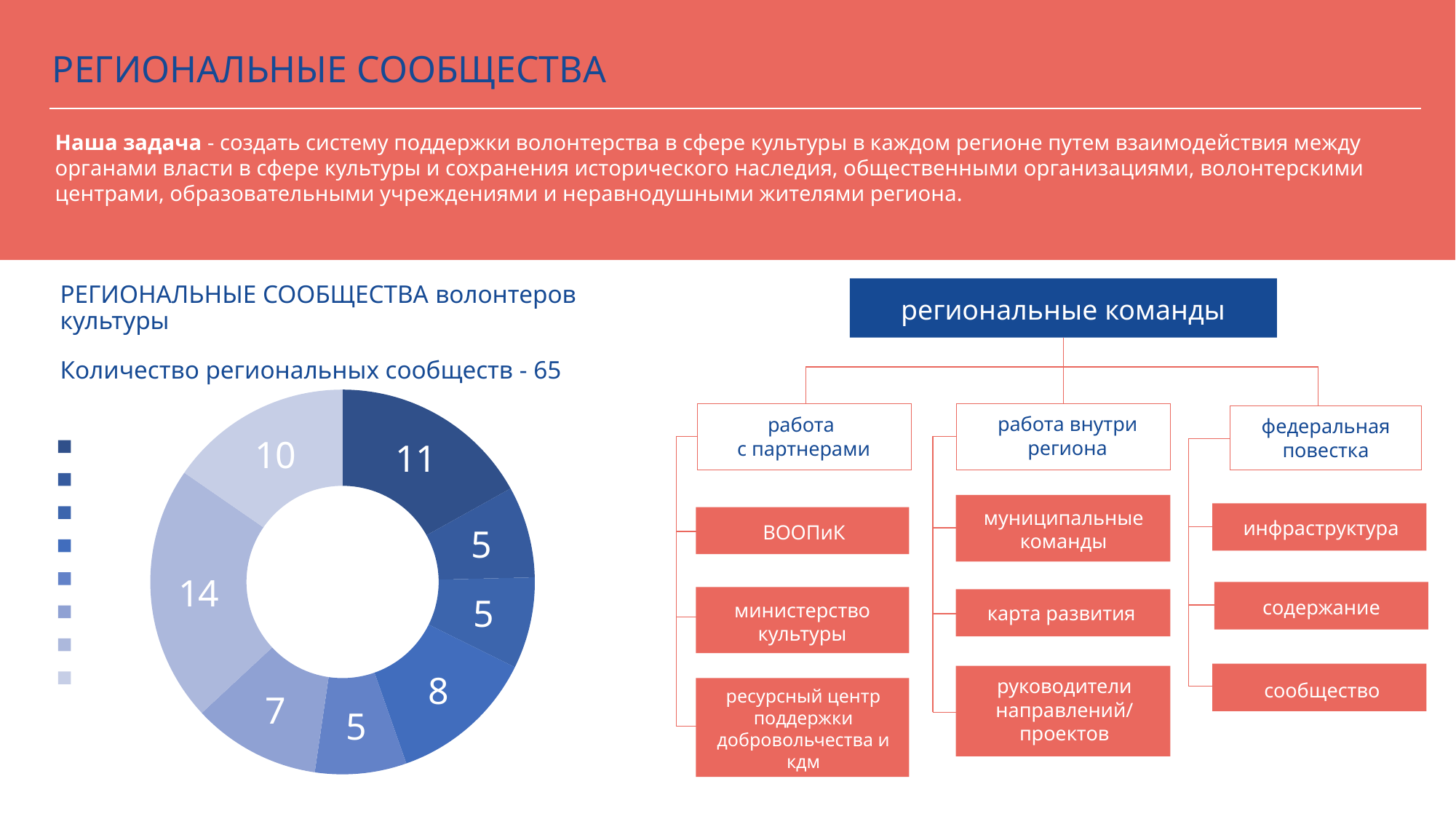
What is the combined value of the three slices labelled 5 in the donut chart? 15 How many slices in the donut chart have the value 5? 3 What is the difference between the dark blue slice at the top right (11) and the light slice at the top left (10)? 1 What is the title printed above the donut chart? РЕГИОНАЛЬНЫЕ СООБЩЕСТВА волонтеров культуры How many entries does the legend to the left of the donut chart show? 8 What is the value of the smallest slice in the donut chart? 5 Which is larger: the dark blue slice at the top right of the donut or the light slice at the top left? the dark blue slice (11) What is the total number of regional communities stated above the donut chart? 65 What is the difference between the largest slice (14) and the smallest slice (5) in the donut chart? 9 How many slices does the donut chart have? 8 What is the value of the largest slice in the donut chart? 14 What kind of chart is shown on the left side of the slide? pie chart (donut)